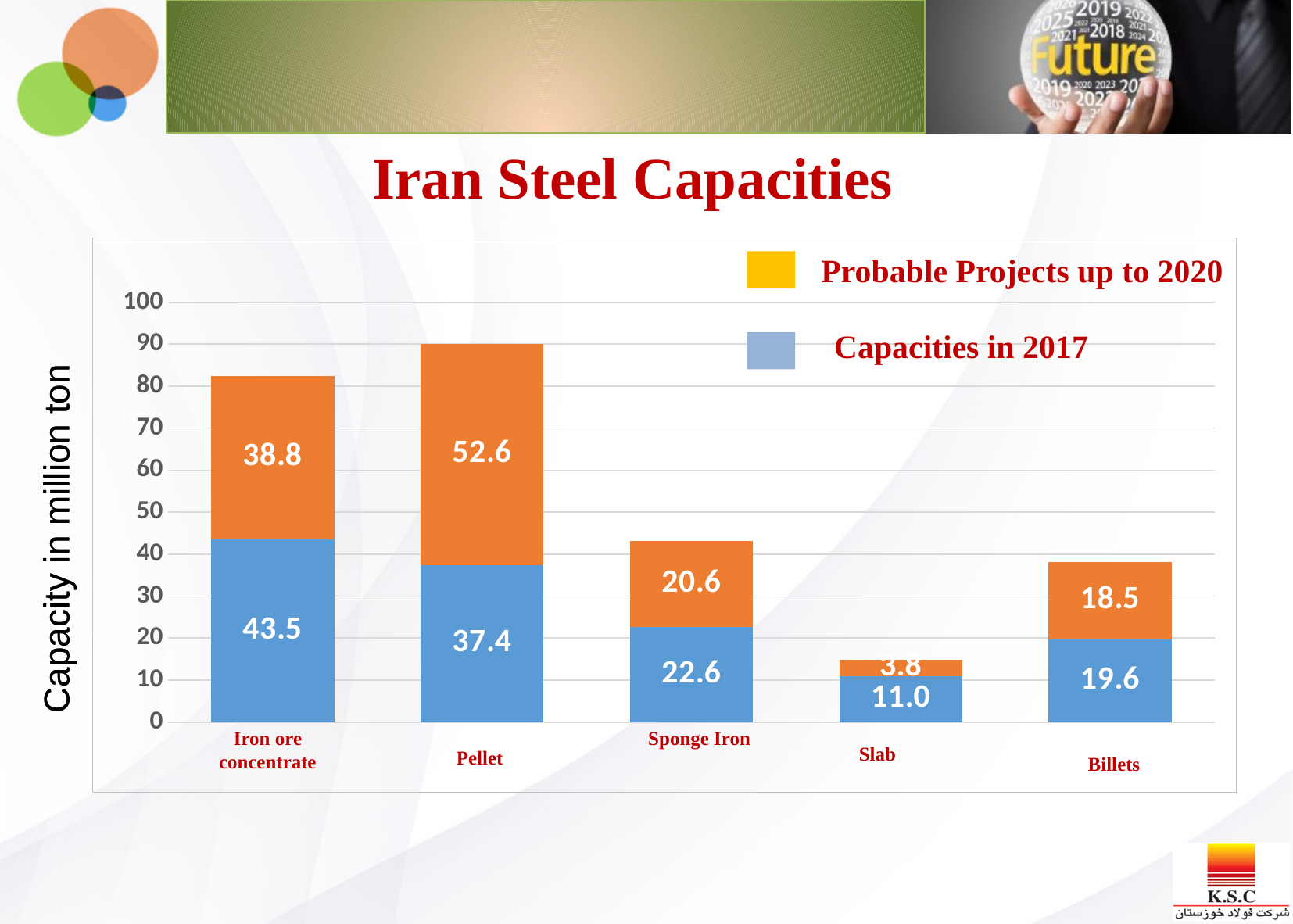
What is the Probable Projects up to 2020 value for Sponge Iron? 20.6 Is the total stacked bar for Iron ore concentrate greater or less than 80? greater What kind of chart is shown on the slide? Stacked bar chart Which is larger: the Capacities in 2017 value for Sponge Iron or for Billets? Sponge Iron How many series does the legend list? 2 What is the Capacities in 2017 value for Pellet? 37.4 Which category has the lowest Probable Projects up to 2020 value? Slab What is the difference between the Probable Projects up to 2020 values for Pellet and Iron ore concentrate? 13.8 What is the total of the stacked bar for Pellet? 90 How many categories are shown on the x axis? 5 Which category has the highest Capacities in 2017 value? Iron ore concentrate What is the Capacities in 2017 value for Billets? 19.6